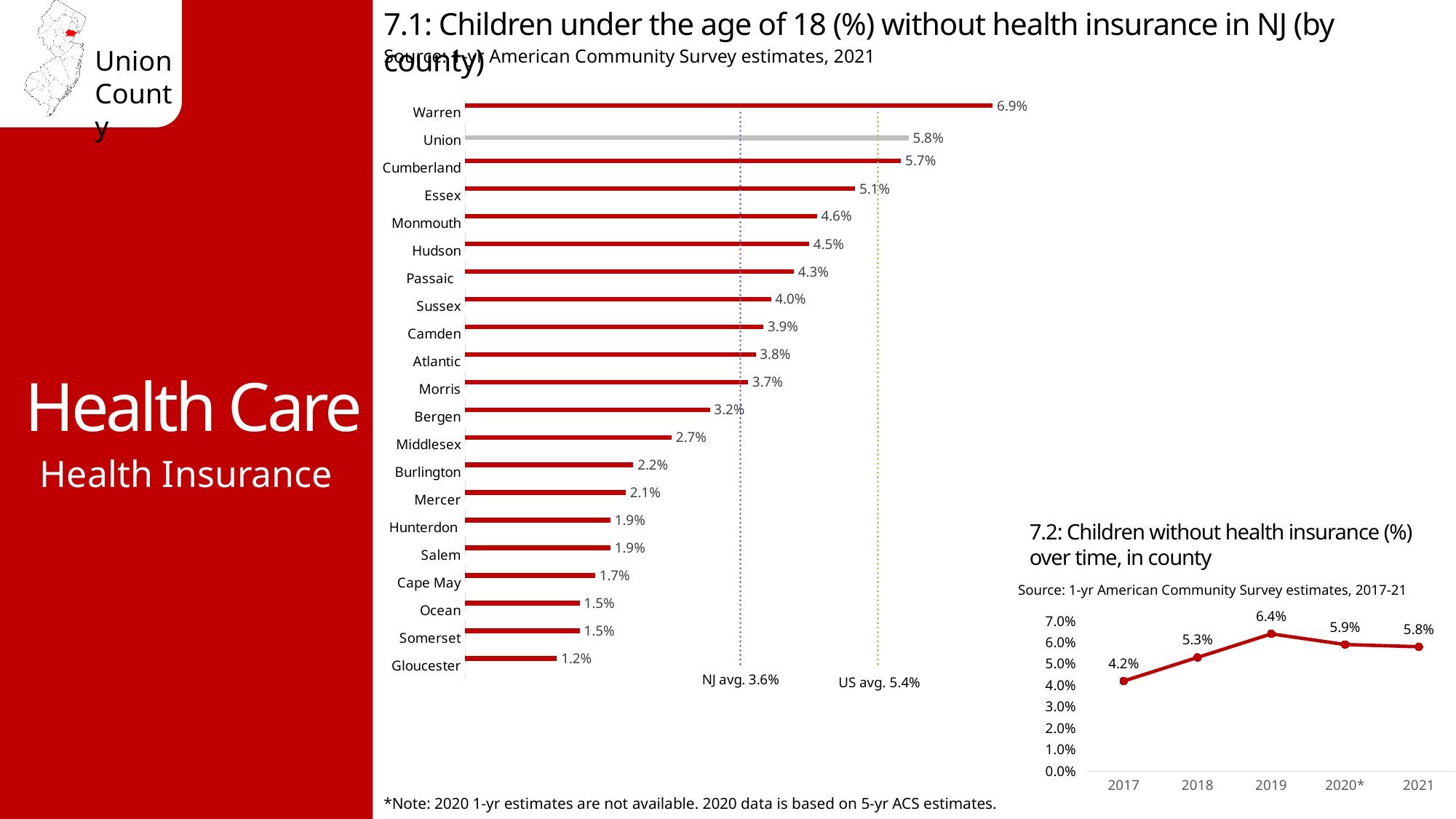
In chart 7.1, how many counties are shown? 21 In chart 7.1, what is the value for Hudson? 4.5% In chart 7.2, which year has the lowest value? 2017 In chart 7.1, which county has the lowest percentage of children without health insurance? Gloucester In chart 7.1, which county has the highest percentage of children without health insurance? Warren In chart 7.1, which is larger, the value for Essex or the value for Monmouth? Essex What kind of chart is chart 7.2 (children without health insurance over time)? Line chart In chart 7.1 (children under 18 without health insurance by county), what is the value for Union? 5.8% In chart 7.1, what is the difference between Warren and Gloucester? 5.7% In chart 7.2, what is the difference between the 2019 value and the 2017 value? 2.2% In chart 7.1, what is the NJ average shown by the dotted reference line? 3.6% In chart 7.2, what is the value for 2019? 6.4%